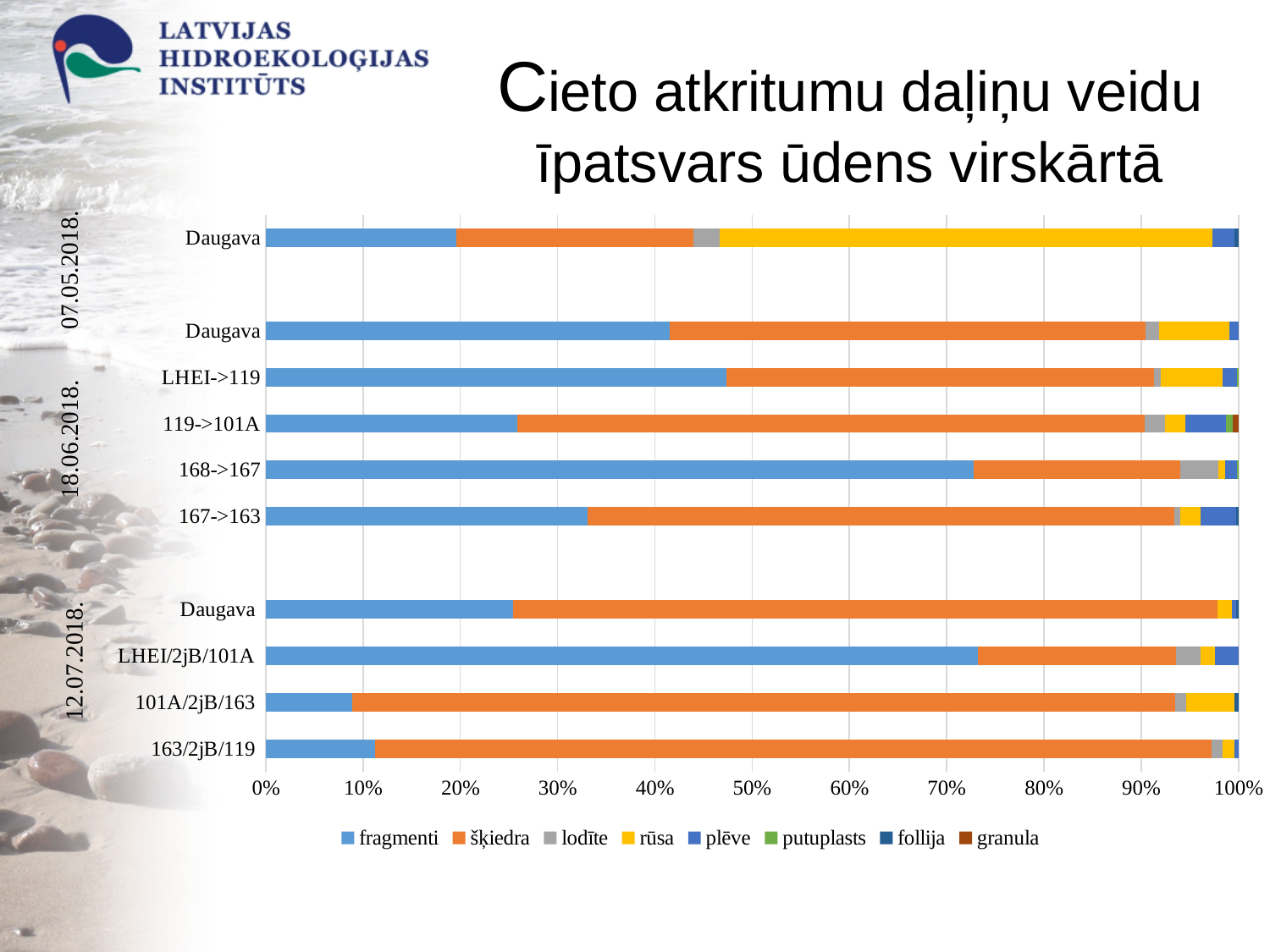
Which has the larger fragmenti share: 167->163 or 163/2jB/119? 167->163 Is the fragmenti share for 101A/2jB/163 greater or less than 20%? less How many bars (sampling sites) are plotted in the chart? 10 Is the fragmenti share for the Daugava bar in the 07.05.2018. group greater or less than 30%? less What kind of chart is shown on the slide? stacked bar chart Is the fragmenti share for 168->167 greater or less than 70%? greater What is the title of the chart on the slide? Cieto atkritumu daļiņu veidu īpatsvars ūdens virskārtā Which has the larger fragmenti share: the Daugava bar in the 18.06.2018. group or 119->101A? Daugava (18.06.2018.) Which series is listed first in the legend? fragmenti How many series does the legend list? 8 Which bar has the largest rūsa (yellow) share? Daugava (07.05.2018.)